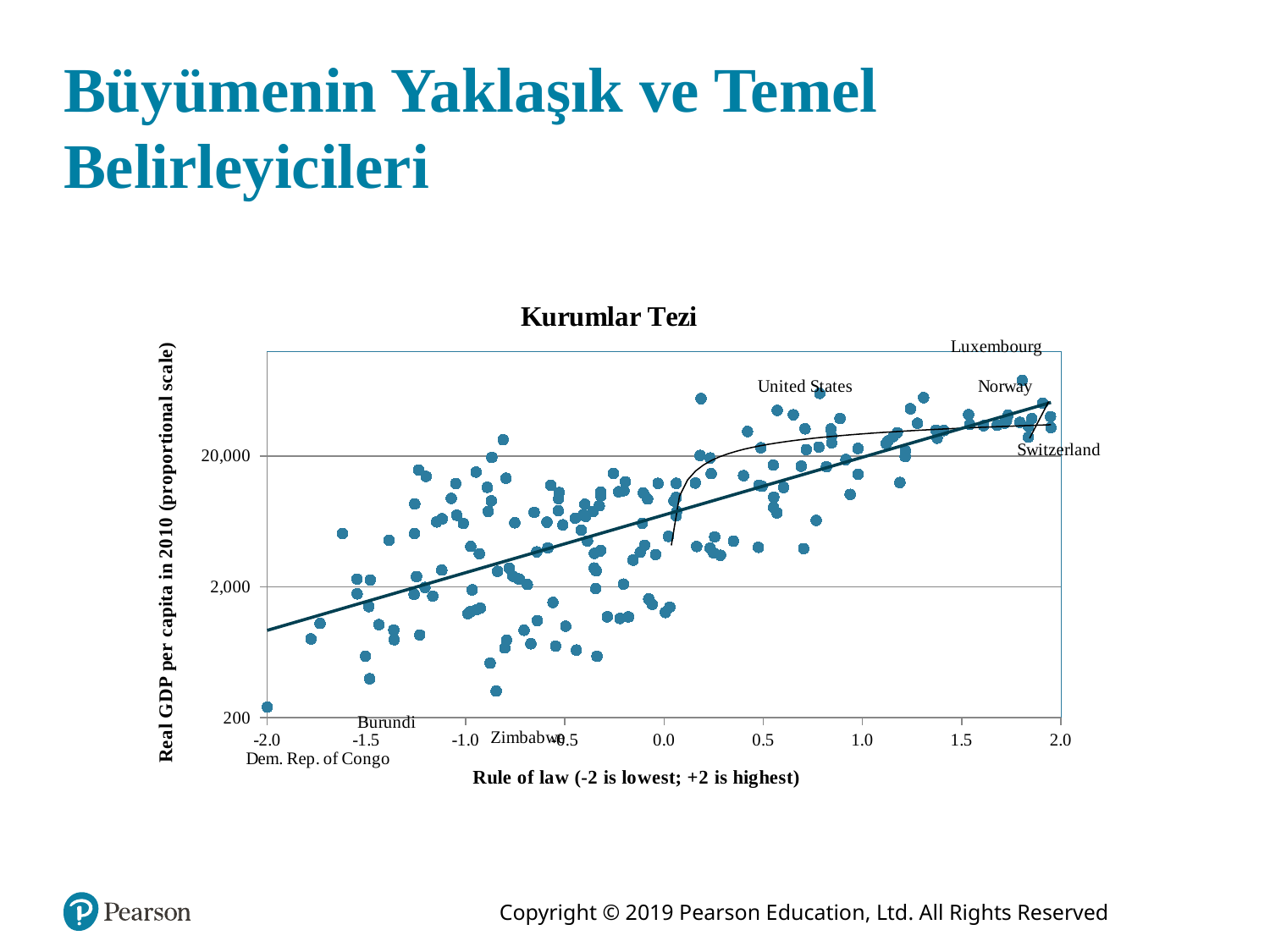
Is the value for Burundi greater or less than 2,000? less Which has the higher real GDP per capita, Luxembourg or Dem. Rep. of Congo? Luxembourg What is the label of the x axis? Rule of law (-2 is lowest; +2 is highest) Is the value for Luxembourg greater or less than 20,000? greater What kind of chart is shown on the slide? Scatter plot Which has the higher real GDP per capita, United States or Zimbabwe? United States Is the value for Dem. Rep. of Congo greater or less than 2,000? less As rule of law increases along the x axis, does real GDP per capita generally rise or fall? Rise Among the labeled countries, which has the highest real GDP per capita? Luxembourg What is the title of the chart? Kurumlar Tezi Among the labeled countries, which has the lowest real GDP per capita? Dem. Rep. of Congo